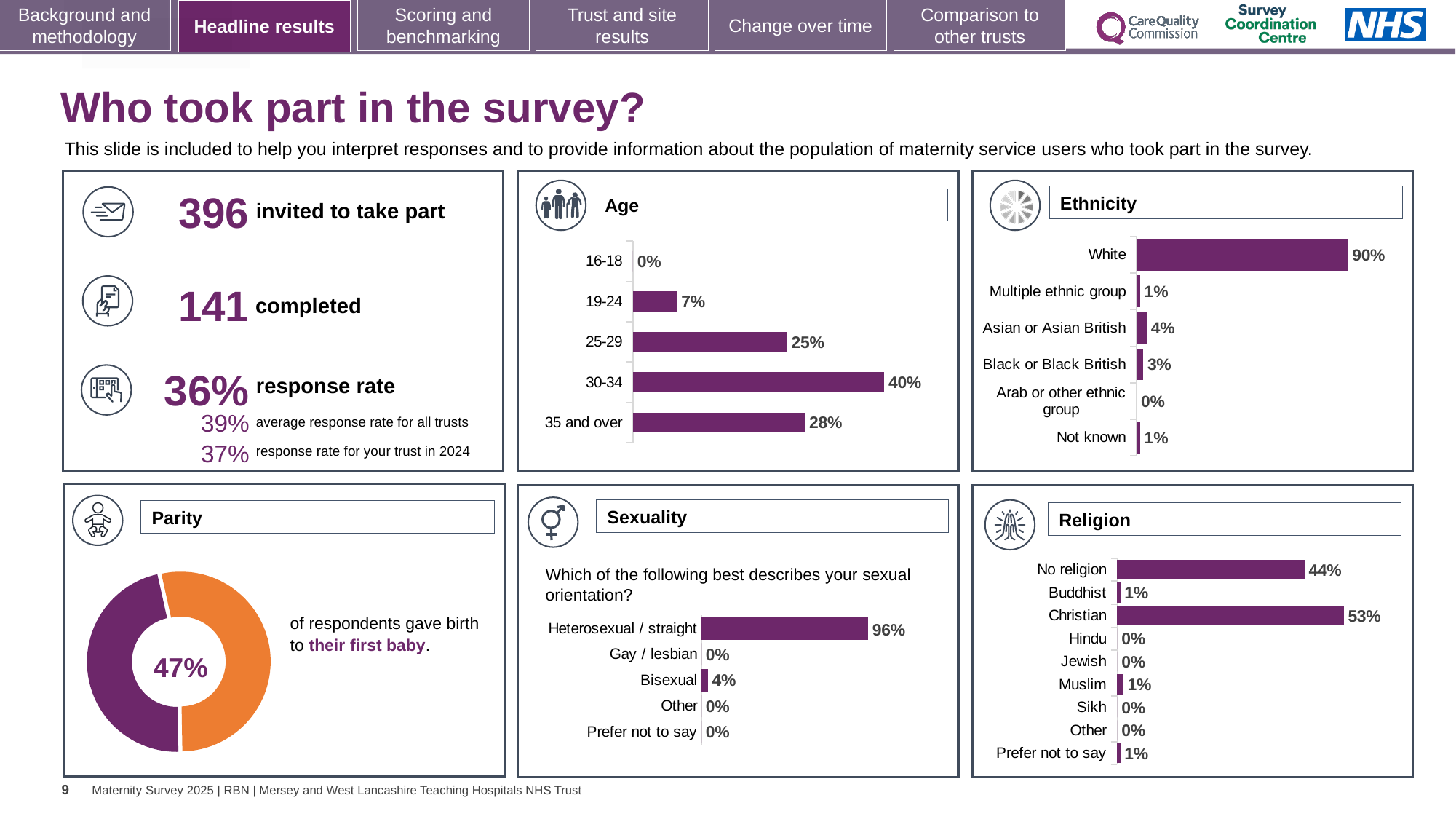
In the Religion chart, what is the difference between Christian and No religion? 9% In the Age chart, what is the difference between the values for 35 and over and 25-29? 3% In the Religion chart, which category has the highest value? Christian In the Sexuality chart, what is the value for Heterosexual / straight? 96% How many categories does the Ethnicity chart show? 6 In the Age chart, which age group has the highest value? 30-34 In the Ethnicity chart, what is the value for White? 90% In the Parity chart, what share of respondents gave birth to their first baby? 47% How many categories does the Religion chart show? 9 In the Age chart, what is the value for the 30-34 age group? 40% In the Ethnicity chart, which is larger, Asian or Asian British or Black or Black British? Asian or Asian British What kind of chart is the Parity chart? Doughnut chart